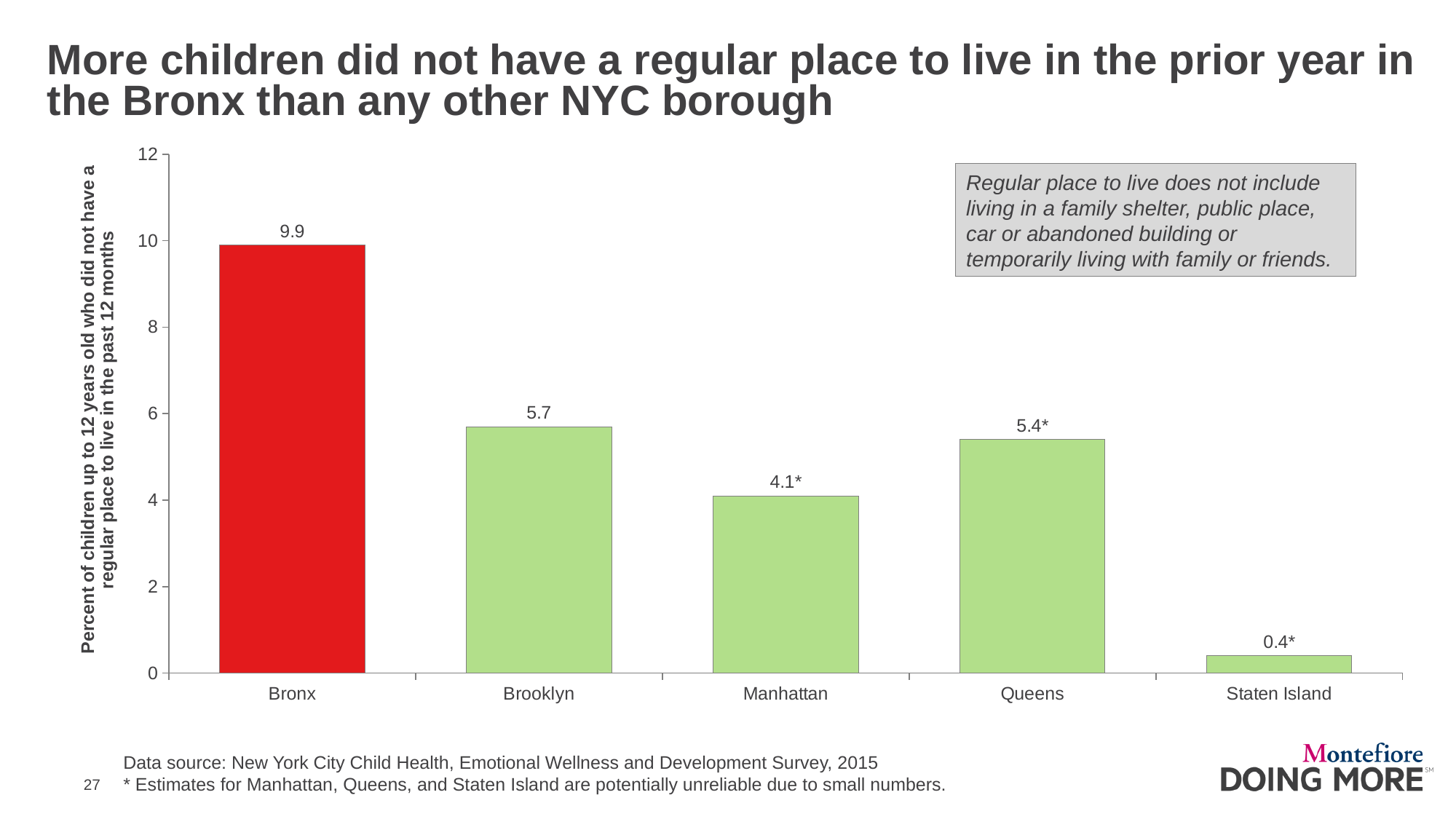
Which bar is coloured red? Bronx What is the value for the Bronx? 9.9 What is the difference between the values for the Bronx and Brooklyn? 4.2 Which borough has the lowest value? Staten Island Which borough has the highest value? Bronx Is the value for Queens greater or less than 6? less What is the value shown for Manhattan? 4.1* What is the value shown for Staten Island? 0.4* Which is larger, the value for Brooklyn or the value for Queens? Brooklyn How many boroughs are shown on the chart? 5 What kind of chart is shown on the slide? bar chart What is the value for Brooklyn? 5.7